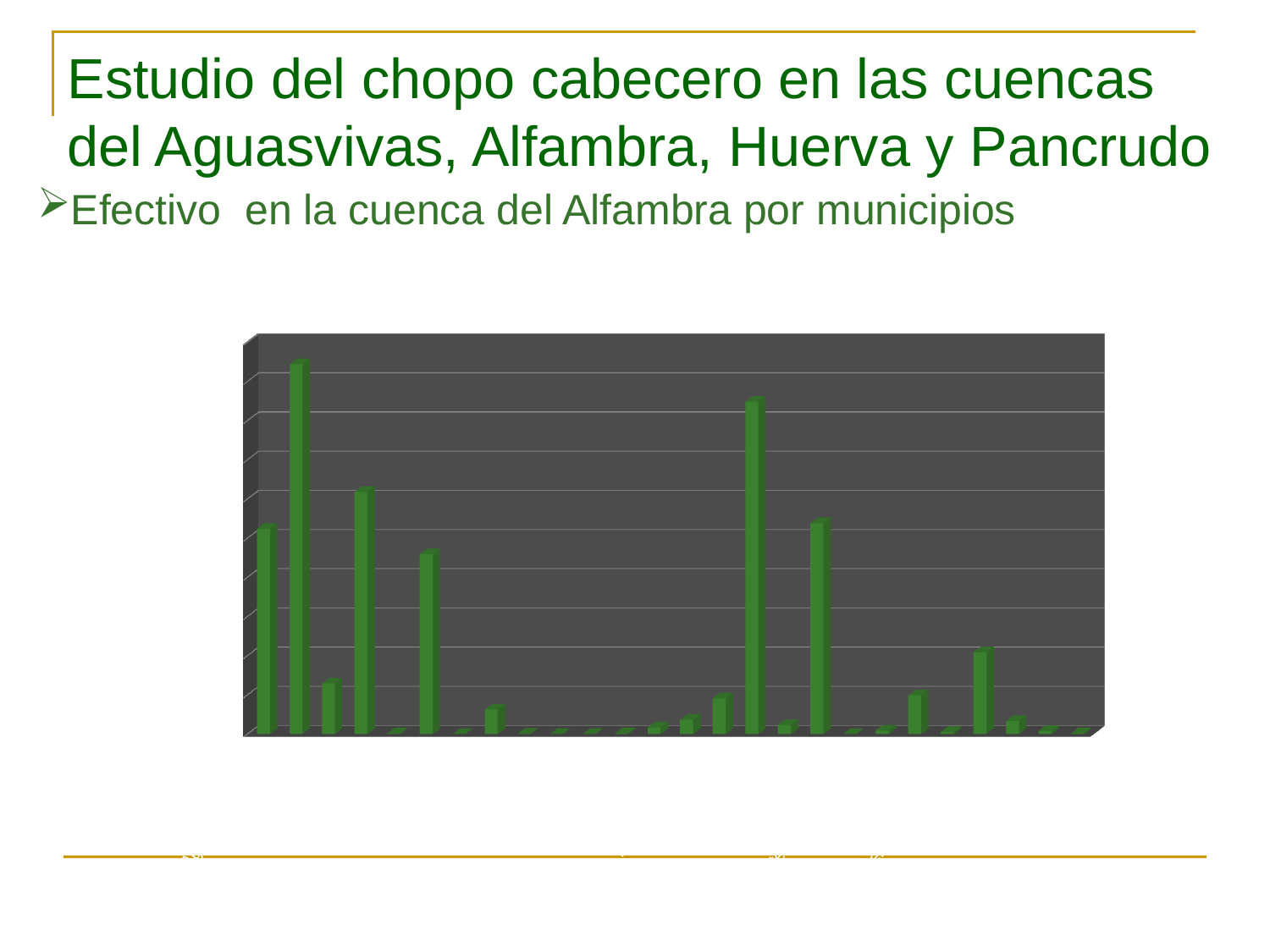
What kind of chart is shown on the slide? bar chart What colour are the bars in the chart? green Is the second-tallest bar in the chart located in the left half or the right half of the chart? right half Is the tallest bar in the chart located in the left half or the right half of the chart? left half Is the tallest bar in the chart the first bar from the left or the second bar from the left? second bar from the left